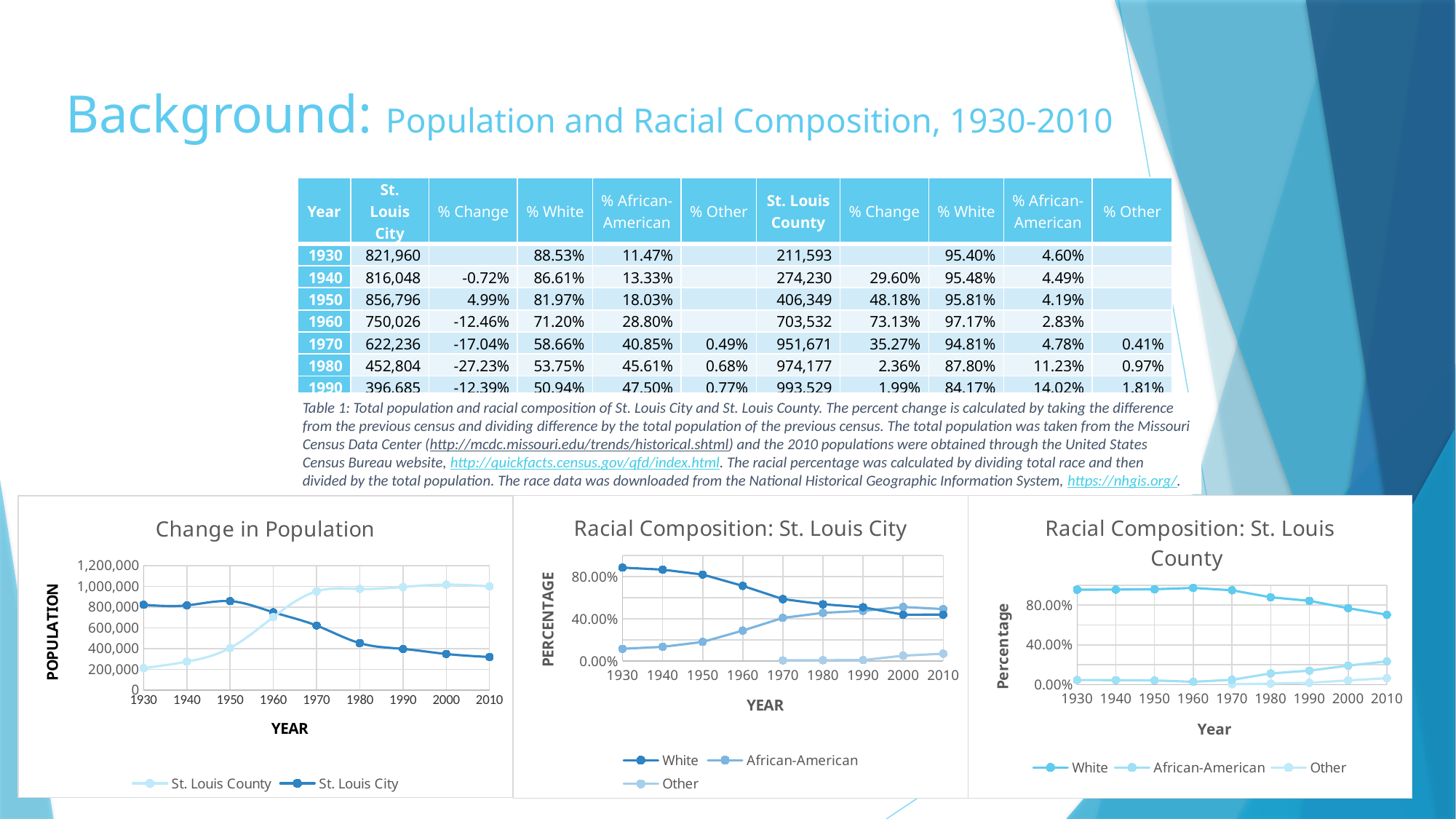
How many years are shown on the x axis of the "Change in Population" chart? 9 In the "Change in Population" chart, is the value for St. Louis City in 2010 greater or less than 400,000? less In the "Racial Composition: St. Louis City" chart, does the White line rise or fall from 1930 to 2010? fall What kind of chart is the "Change in Population" chart? line chart In the "Change in Population" chart, which series has the larger value in 2010, St. Louis County or St. Louis City? St. Louis County In the "Racial Composition: St. Louis County" chart, is the value for White in 2010 greater or less than 80.00%? less How many series does the legend of the "Change in Population" chart list? 2 What is the title of the rightmost chart on the slide? Racial Composition: St. Louis County In the "Racial Composition: St. Louis City" chart, is the value for White in 1930 greater or less than 80.00%? greater In the "Change in Population" chart, does the St. Louis City line rise or fall from 1950 to 2010? fall How many series does the legend of the "Racial Composition: St. Louis City" chart list? 3